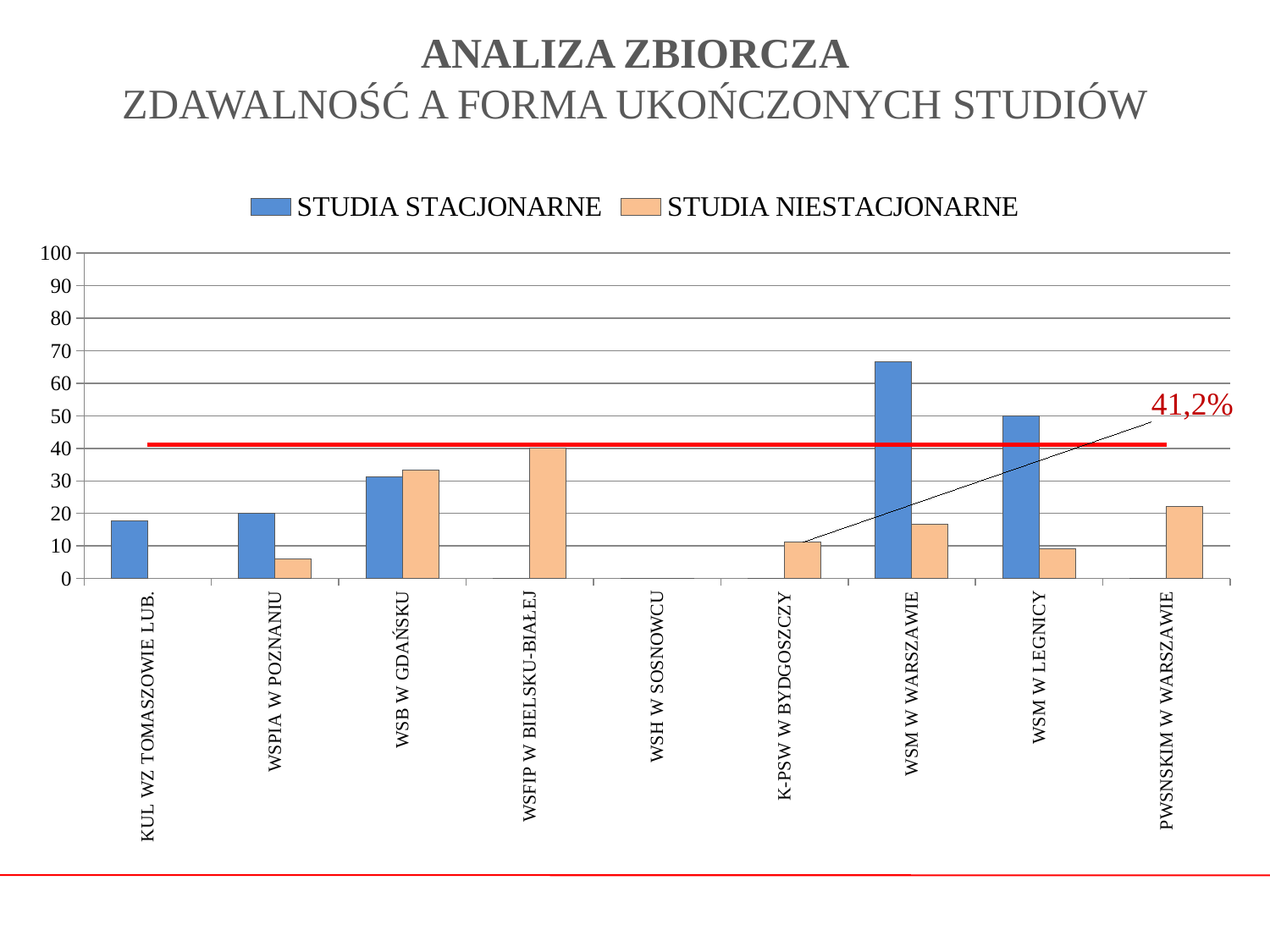
What are the two legend entries of the chart? STUDIA STACJONARNE and STUDIA NIESTACJONARNE How many series does the legend list? 2 Which institution has the highest value for STUDIA STACJONARNE? WSM W WARSZAWIE For WSM W LEGNICY, which series has the larger value: STUDIA STACJONARNE or STUDIA NIESTACJONARNE? STUDIA STACJONARNE Is the STUDIA STACJONARNE value for KUL WZ TOMASZOWIE LUB. greater or less than 20? less What value is labelled on the red horizontal reference line? 41,2% Is the STUDIA NIESTACJONARNE value for WSPIA W POZNANIU greater or less than 10? less Which has the larger STUDIA NIESTACJONARNE value: PWSNSKIM W WARSZAWIE or K-PSW W BYDGOSZCZY? PWSNSKIM W WARSZAWIE Is the STUDIA STACJONARNE value for WSM W WARSZAWIE greater or less than 60? greater Which institution has the highest value for STUDIA NIESTACJONARNE? WSFIP W BIELSKU-BIAŁEJ How many institutions (categories) are shown on the x axis? 9 What kind of chart is shown on the slide? bar chart